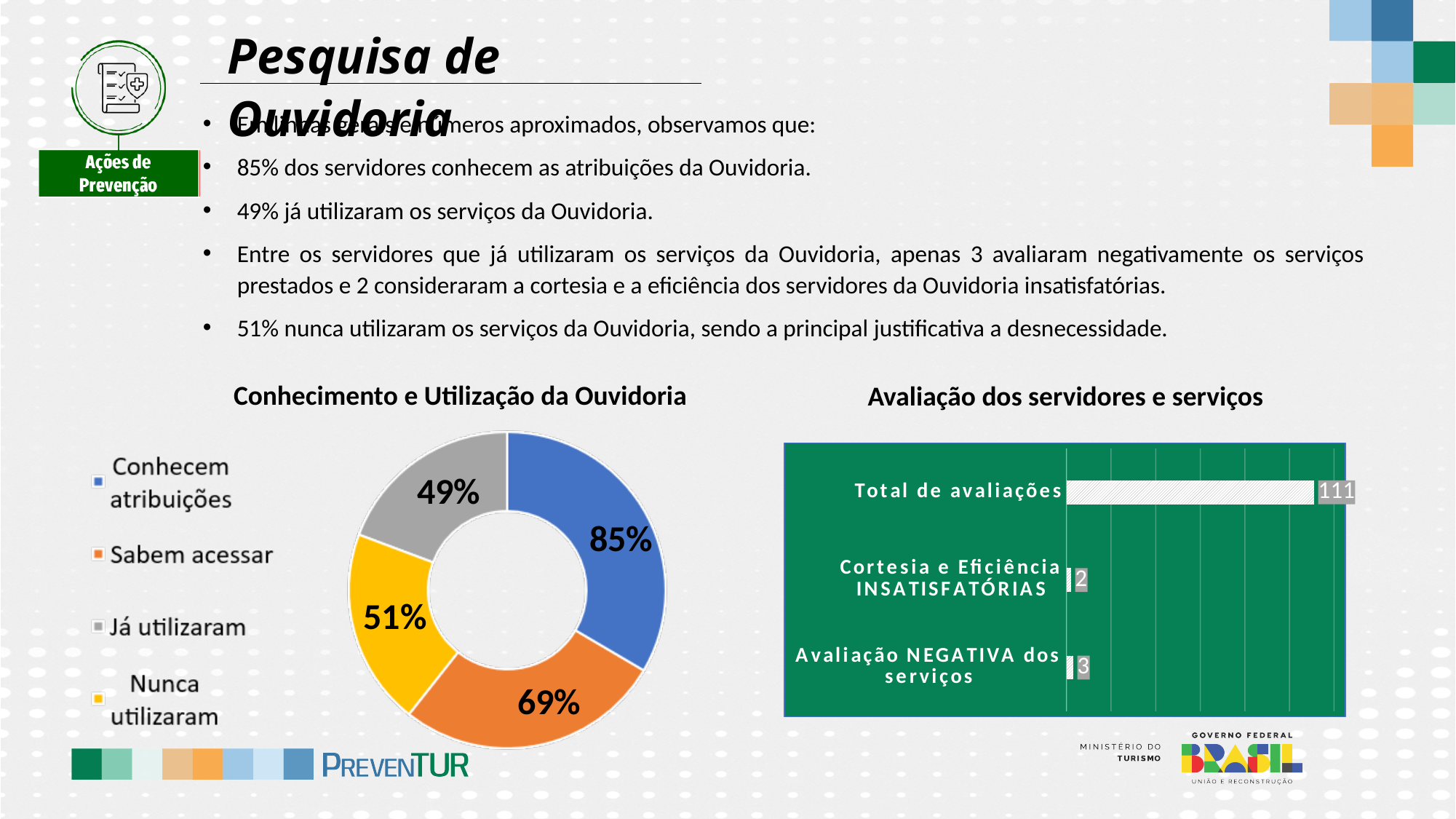
In the chart titled "Avaliação dos servidores e serviços", what is the value for "Avaliação NEGATIVA dos serviços"? 3 In the chart titled "Conhecimento e Utilização da Ouvidoria", which category has the lowest value? Já utilizaram In the chart titled "Conhecimento e Utilização da Ouvidoria", how many categories does the legend list? 4 In the chart titled "Conhecimento e Utilização da Ouvidoria", what value is shown for "Conhecem atribuições"? 85% In the chart titled "Avaliação dos servidores e serviços", which is larger: "Avaliação NEGATIVA dos serviços" or "Cortesia e Eficiência INSATISFATÓRIAS"? Avaliação NEGATIVA dos serviços In the chart titled "Conhecimento e Utilização da Ouvidoria", what is the difference between the values for "Conhecem atribuições" and "Já utilizaram"? 36 percentage points What kind of chart is the one titled "Avaliação dos servidores e serviços"? Bar chart In the chart titled "Avaliação dos servidores e serviços", which category has the lowest value? Cortesia e Eficiência INSATISFATÓRIAS In the chart titled "Conhecimento e Utilização da Ouvidoria", what value is shown for "Sabem acessar"? 69% What kind of chart is the one titled "Conhecimento e Utilização da Ouvidoria"? Donut (pie) chart In the chart titled "Avaliação dos servidores e serviços", what is the value for "Total de avaliações"? 111 In the chart titled "Conhecimento e Utilização da Ouvidoria", what value is shown for "Nunca utilizaram"? 51%